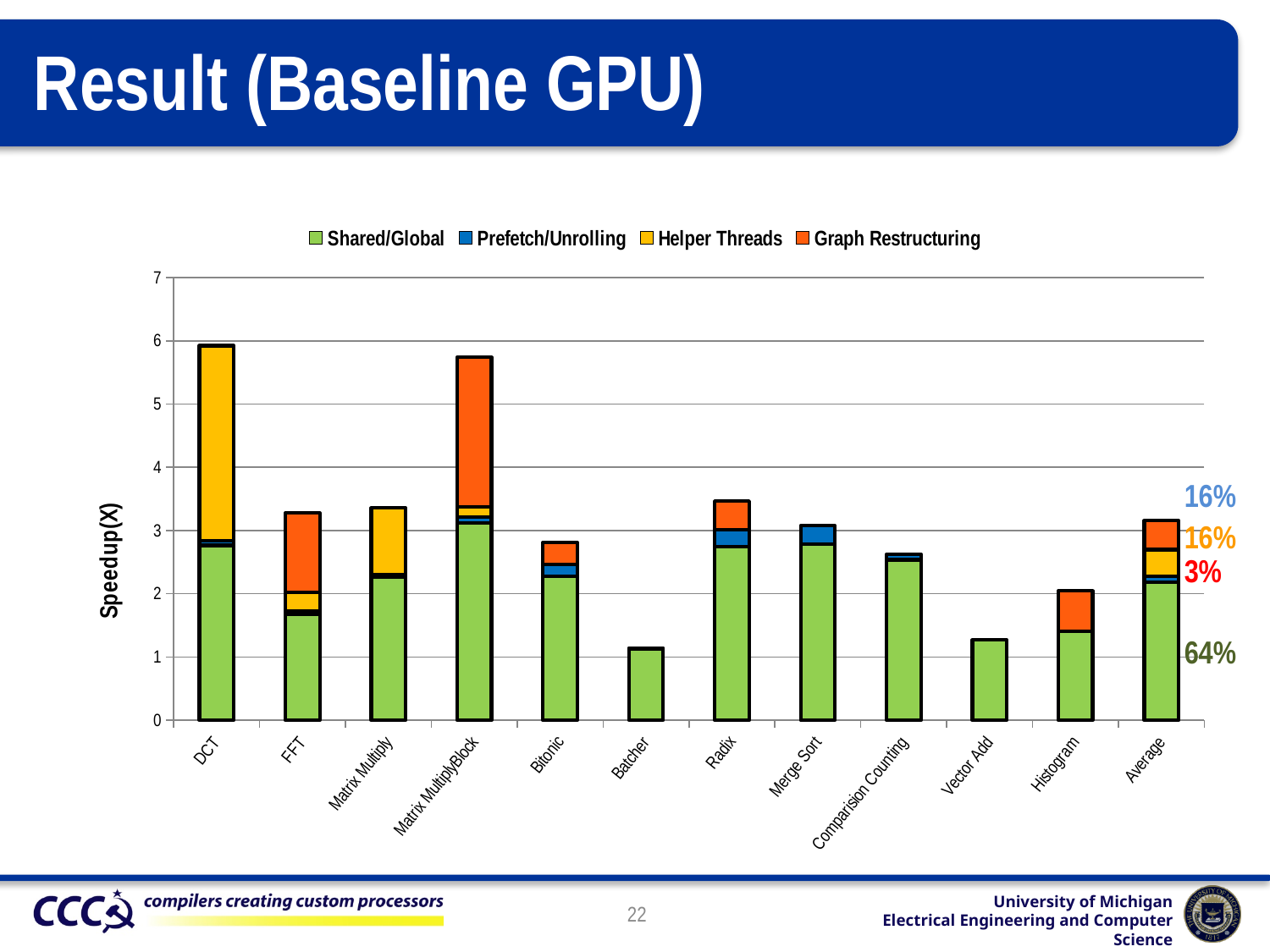
Is the total speedup for Histogram greater or less than 3? less What is the label on the y axis? Speedup(X) How many categories are shown along the x axis? 12 Which has the larger total speedup, Radix or Histogram? Radix Is the total speedup for Vector Add greater or less than 2? less Which has the larger total speedup, DCT or FFT? DCT Is the total speedup for Matrix MultiplyBlock greater or less than 5? greater What kind of chart is shown on the slide? bar chart How many series does the legend list? 4 Which series is shown in green in the legend? Shared/Global